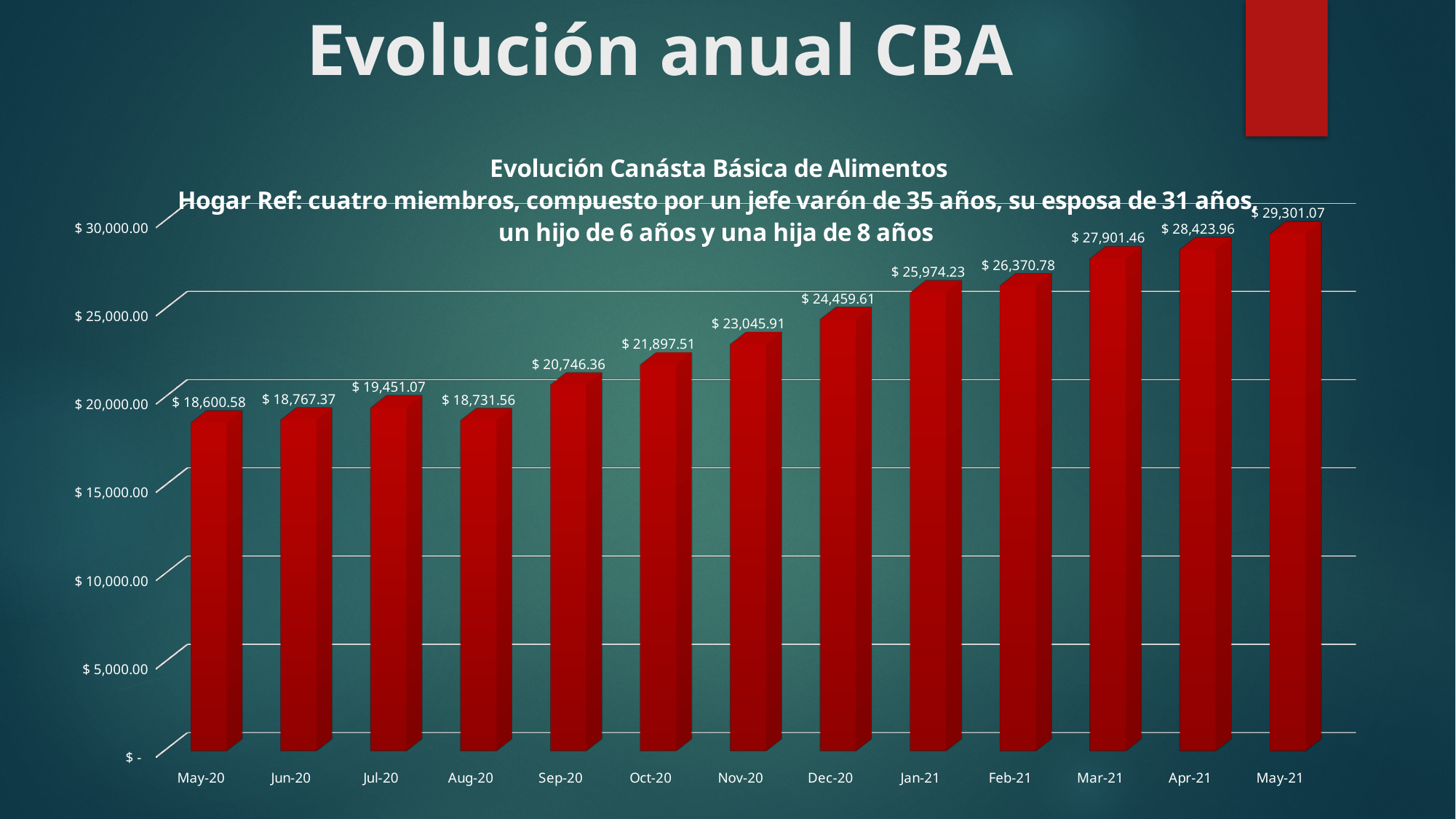
Which month has the highest value? May-21 Is the value for Sep-20 greater or less than $ 20,000.00? greater What is the value for Mar-21? $ 27,901.46 What kind of chart is shown on the slide? Bar chart Which month has the lowest value? May-20 What is the value for Dec-20? $ 24,459.61 What is the value for Aug-20? $ 18,731.56 What is the difference between the values for May-21 and May-20? $ 10,700.49 Do the values generally rise or fall from May-20 to May-21? Rise How many months are shown on the x axis? 13 What is the difference between the values for Dec-20 and Nov-20? $ 1,413.70 Which is larger, the value for Jul-20 or the value for Aug-20? Jul-20